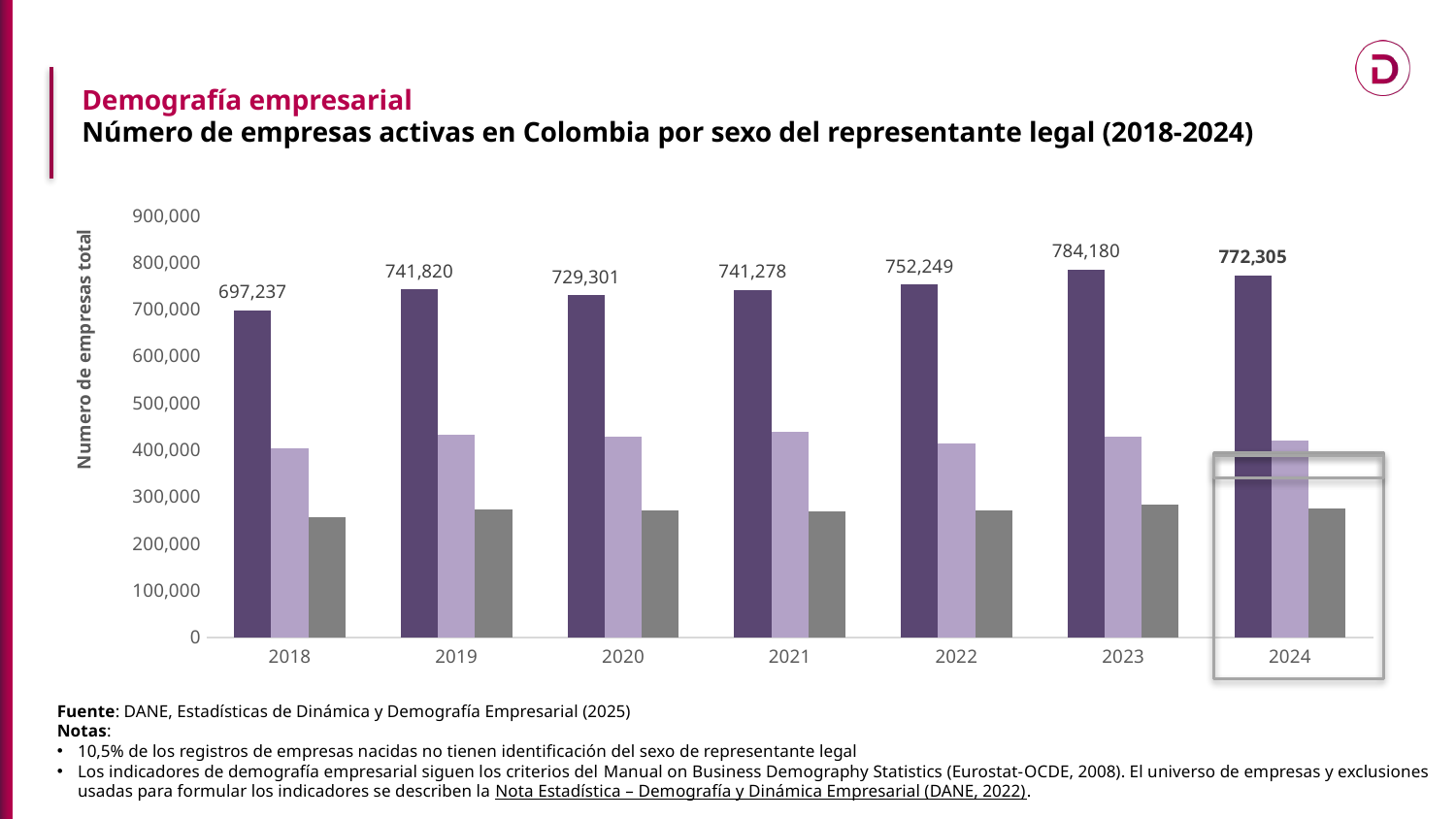
Is the value of the light purple bar for 2021 greater or less than 400,000? greater Which year has the highest labelled value? 2023 Is the value of the grey bar for 2018 greater or less than 300,000? less How many years are shown on the x axis? 7 What is the labelled value for 2018? 697,237 Which is larger, the labelled value for 2018 or for 2022? 2022 Which year has the lowest labelled value? 2018 What kind of chart is shown on the slide? Bar chart What is the labelled value for 2023? 784,180 What is the difference between the labelled values for 2023 and 2024? 11,875 What is the labelled value for 2024? 772,305 What is the label of the y axis? Numero de empresas total